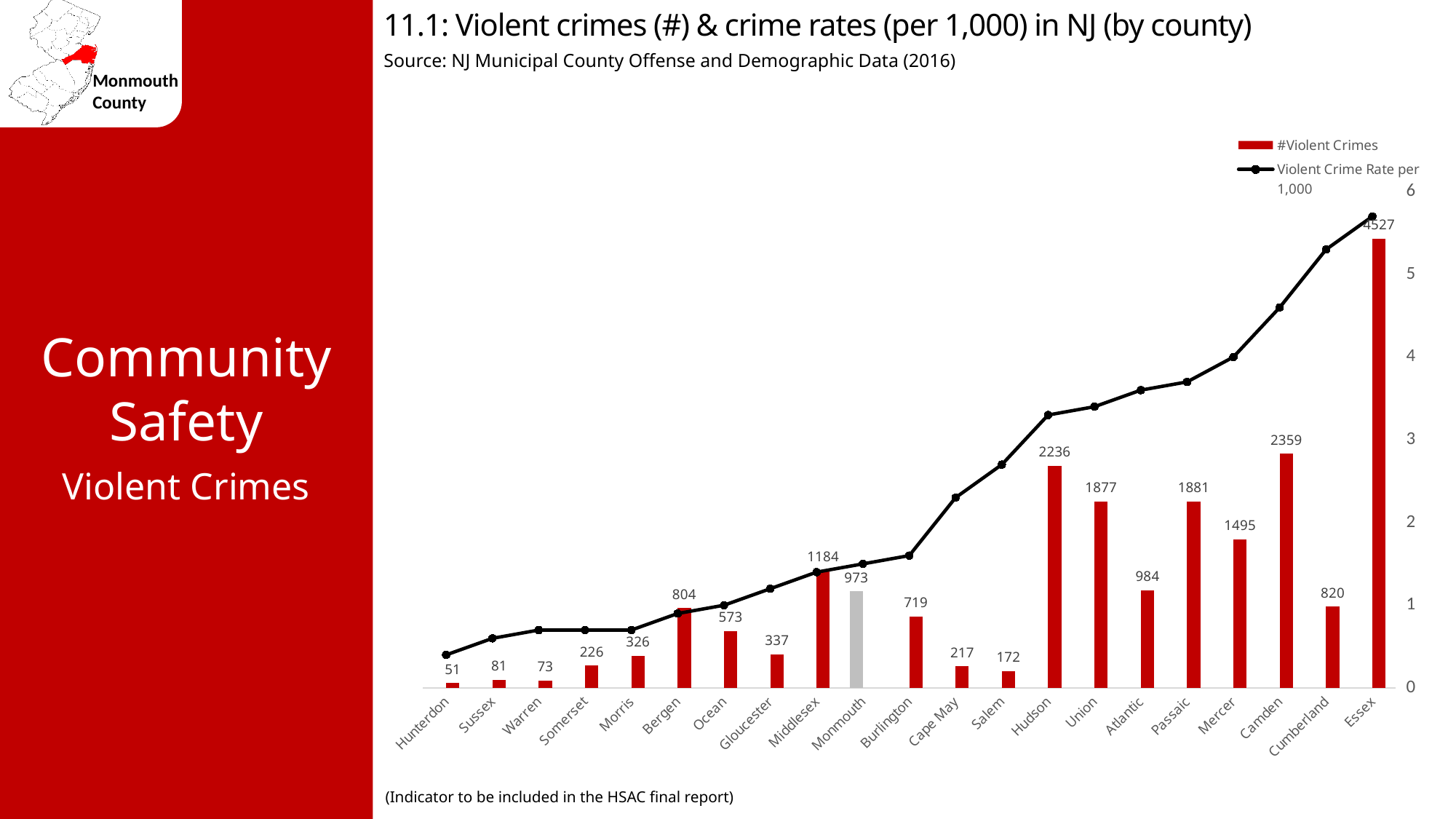
Does the violent crime rate per 1,000 line generally rise or fall from left to right across the counties? rise What is the number of violent crimes for Monmouth County? 973 What is the number of violent crimes for Hudson County? 2236 How many counties are shown on the x axis? 21 Is the violent crime rate per 1,000 for Hunterdon greater or less than 1? less Which county has more violent crimes, Camden or Hudson? Camden Which county has the highest number of violent crimes? Essex Which county's bar is coloured grey instead of red? Monmouth How many series does the legend list? 2 Which county has the lowest number of violent crimes? Hunterdon Is the violent crime rate per 1,000 for Essex greater or less than 5? greater What is the difference in the number of violent crimes between Essex and Camden? 2168